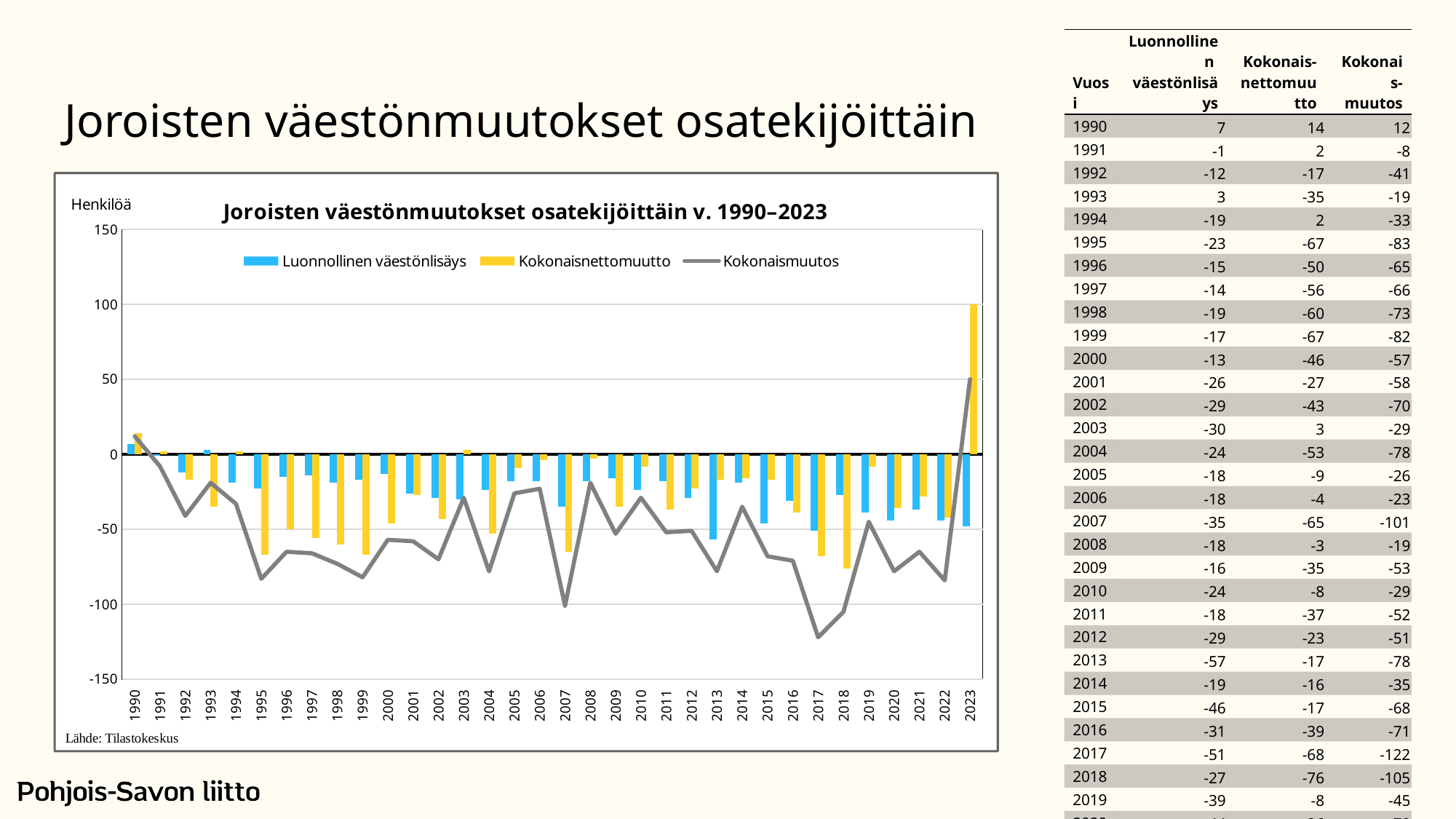
What is the Luonnollinen väestönlisäys value for 2013? -57 How many years are plotted along the x axis of the chart? 34 Which year has the larger Luonnollinen väestönlisäys value, 2013 or 2015? 2015 In which year is the Kokonaismuutos line at its lowest? 2017 What source is cited below the chart? Tilastokeskus What kind of chart is shown on the slide? bar chart with a line In which year is the Kokonaisnettomuutto bar highest? 2023 What is the difference between the Kokonaismuutos values for 2017 and 2018? 17 What colour are the Kokonaisnettomuutto bars in the chart? yellow What is the Kokonaismuutos value for 2017? -122 Is the Kokonaisnettomuutto value for 2023 greater or less than 50? greater How many series does the chart legend list? 3